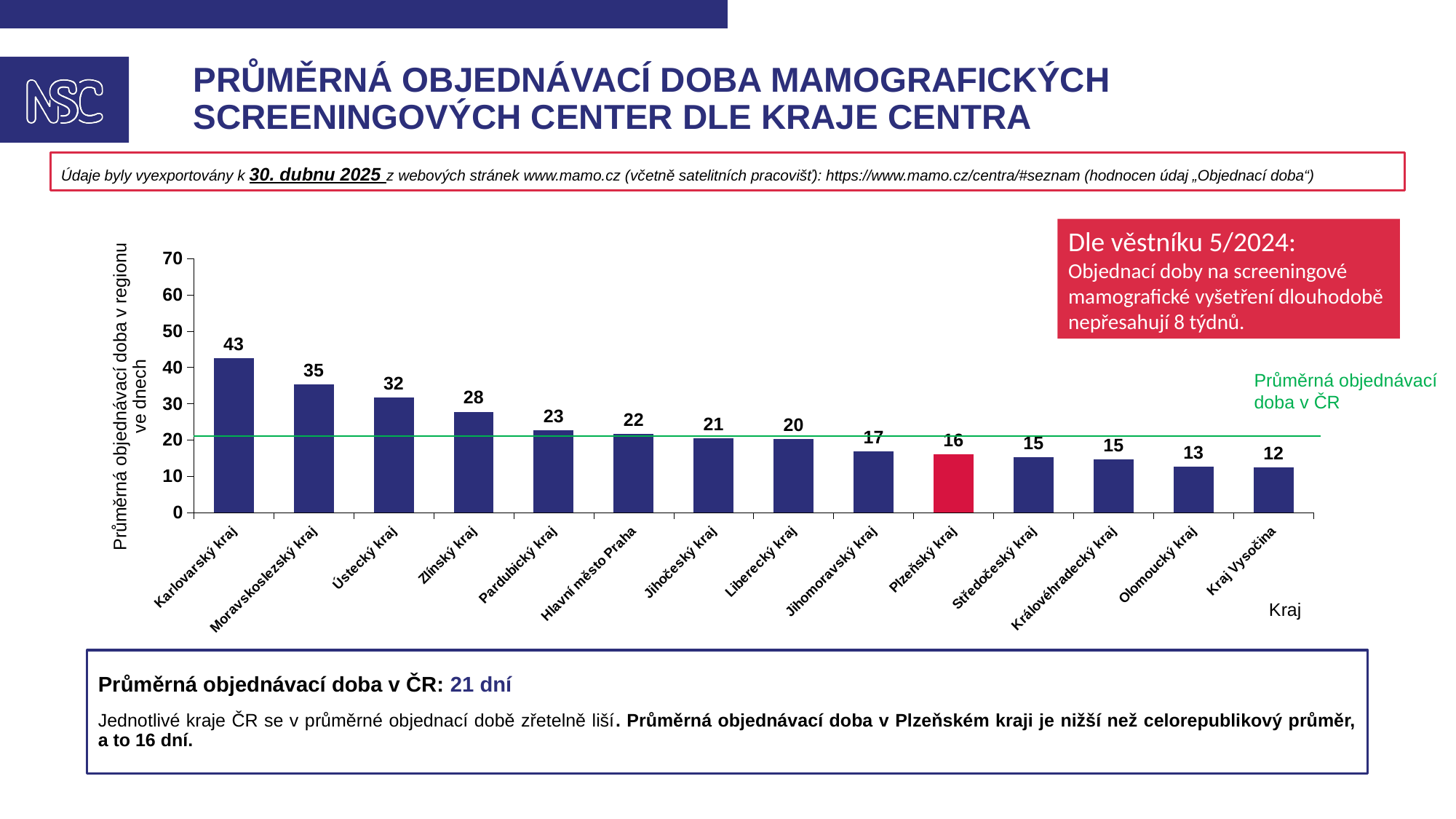
How many regions are shown on the x axis of the chart? 14 Which region has the highest average ordering time? Karlovarský kraj What value is shown for Plzeňský kraj? 16 Is the value for Pardubický kraj greater or less than 20? greater Which region has the lowest average ordering time? Kraj Vysočina Which has a larger value, Ústecký kraj or Zlínský kraj? Ústecký kraj What value is shown for Hlavní město Praha? 22 What is the average ordering time shown for Karlovarský kraj? 43 What is the difference between the values for Karlovarský kraj and Moravskoslezský kraj? 8 What kind of chart is shown on the slide? bar chart Which bar in the chart is coloured red instead of dark blue? Plzeňský kraj What is the difference between the values for Plzeňský kraj and Kraj Vysočina? 4